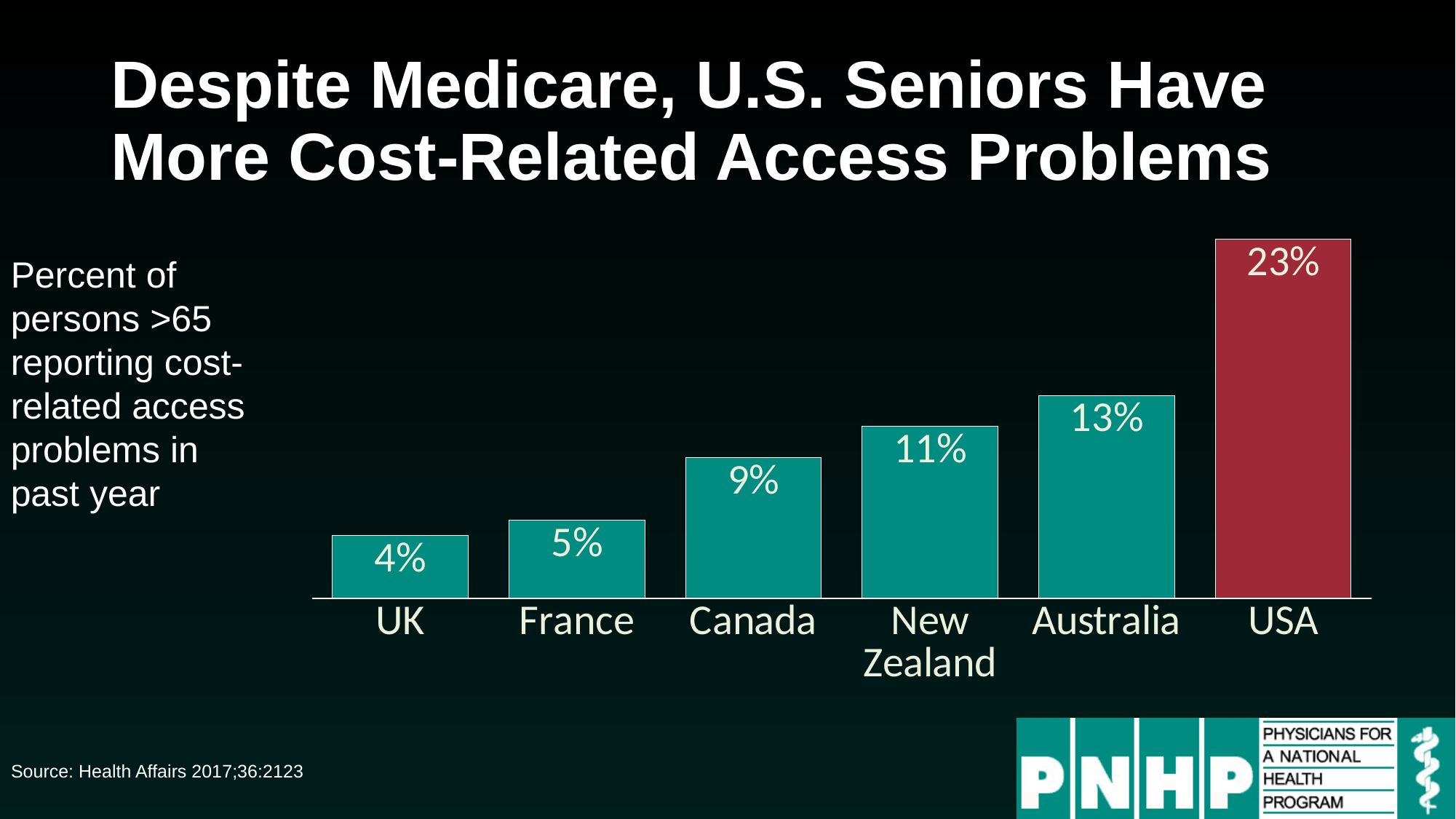
Which country has the highest percentage of seniors reporting cost-related access problems? USA Do the values rise or fall moving from UK to USA along the x axis? Rise What is the value shown for New Zealand? 11% What percent of persons over 65 in the USA reported cost-related access problems in the past year? 23% Which bar is coloured differently (red) from the others? USA Which country has the lowest percentage of seniors reporting cost-related access problems? UK What is the difference between the France value and the UK value? 1% What is the difference between the USA value and the Australia value? 10% What kind of chart is shown on the slide? Bar chart What is the value shown for Canada? 9% How many countries are shown in the chart? 6 Which has a higher value, Canada or New Zealand? New Zealand